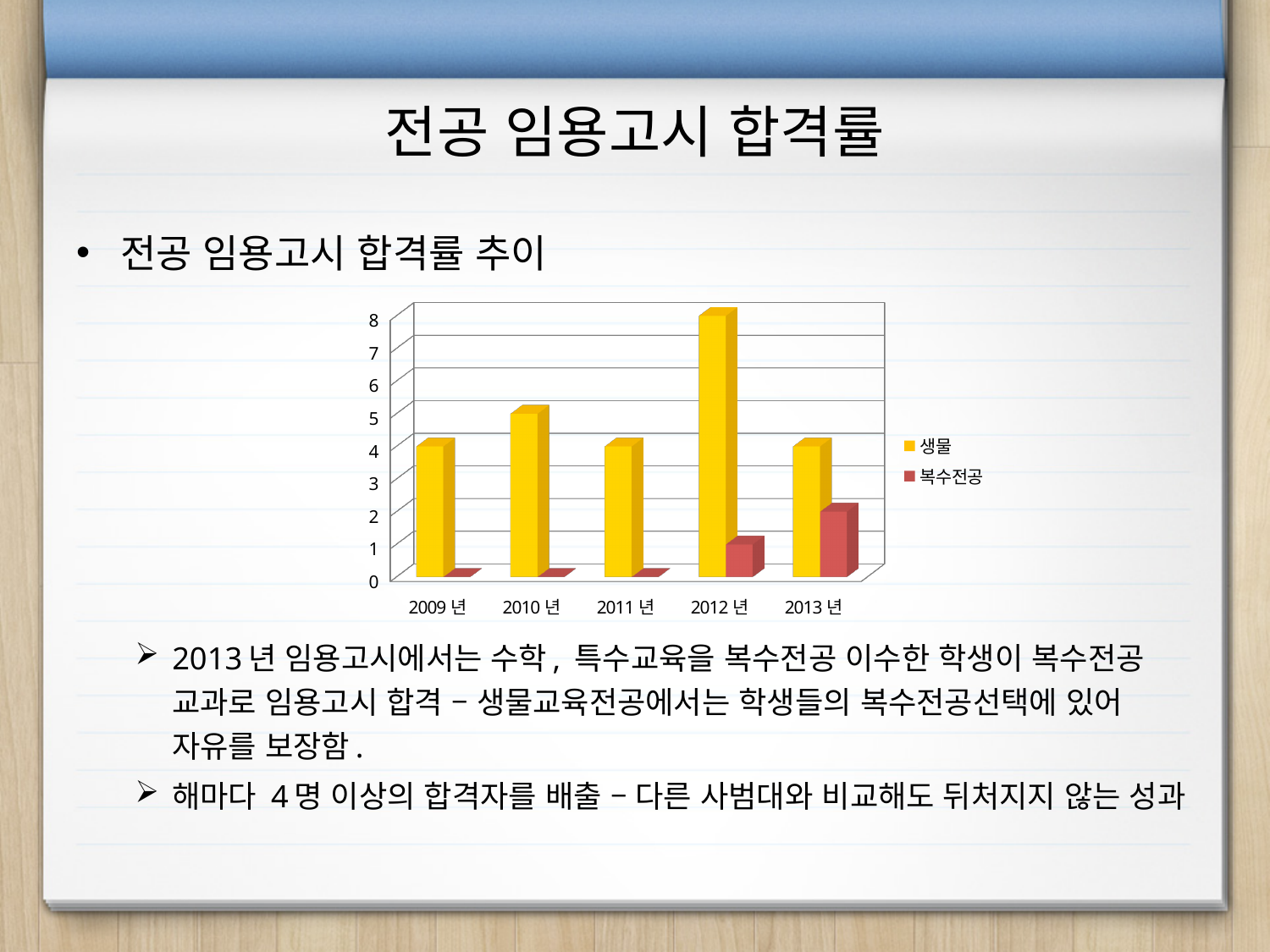
What is the value for 생물 in 2010 년? 5 Which year has the highest value for 복수전공? 2013 년 What is the value for 복수전공 in 2013 년? 2 Which series is shown in yellow in the legend? 생물 What kind of chart is shown on the slide? bar chart How many years are shown on the x axis of the chart? 5 Which is larger, the 생물 value in 2010 년 or the 생물 value in 2011 년? 2010 년 Which series is shown in red in the legend? 복수전공 Is the value for 생물 in 2012 년 greater or less than 6? greater What is the value for 생물 in 2012 년? 8 Which year has the highest value for 생물? 2012 년 How many series does the legend list? 2